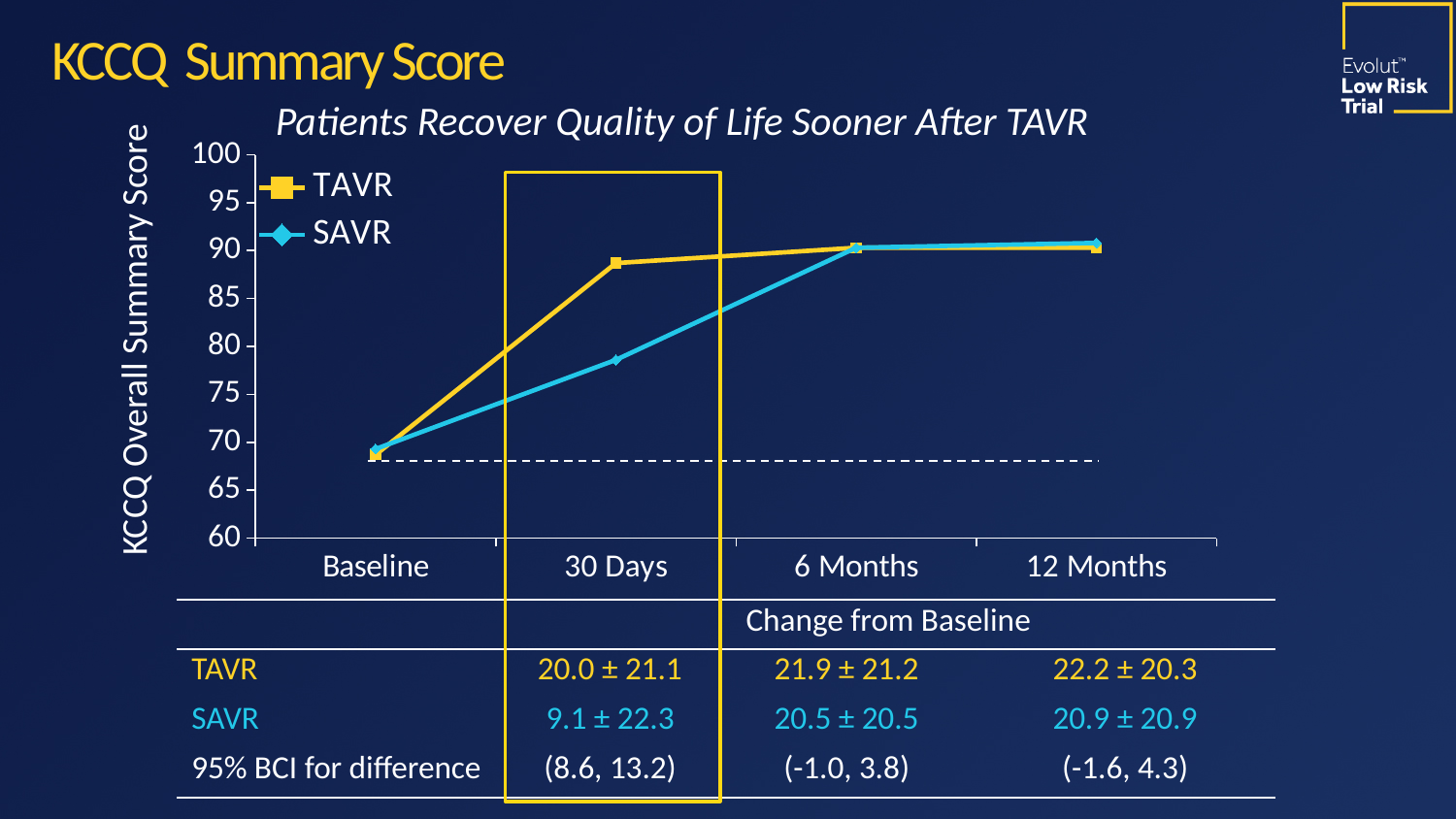
Is the SAVR value at 30 Days greater or less than 80? less At which time point is the SAVR score lowest? Baseline What is the title of the y axis of the chart? KCCQ Overall Summary Score Is the TAVR value at Baseline greater or less than 70? less In the table below the chart, what is the TAVR change from baseline at 30 Days? 20.0 ± 21.1 How many series does the chart legend list? 2 What kind of chart is shown on the slide? line chart How many time points are plotted along the x axis of the chart? 4 Does the TAVR score rise or fall from Baseline to 6 Months? rise Is the TAVR value at 30 Days greater or less than 85? greater Which series is plotted in yellow in the chart? TAVR At 30 Days, which series has the higher KCCQ Overall Summary Score, TAVR or SAVR? TAVR